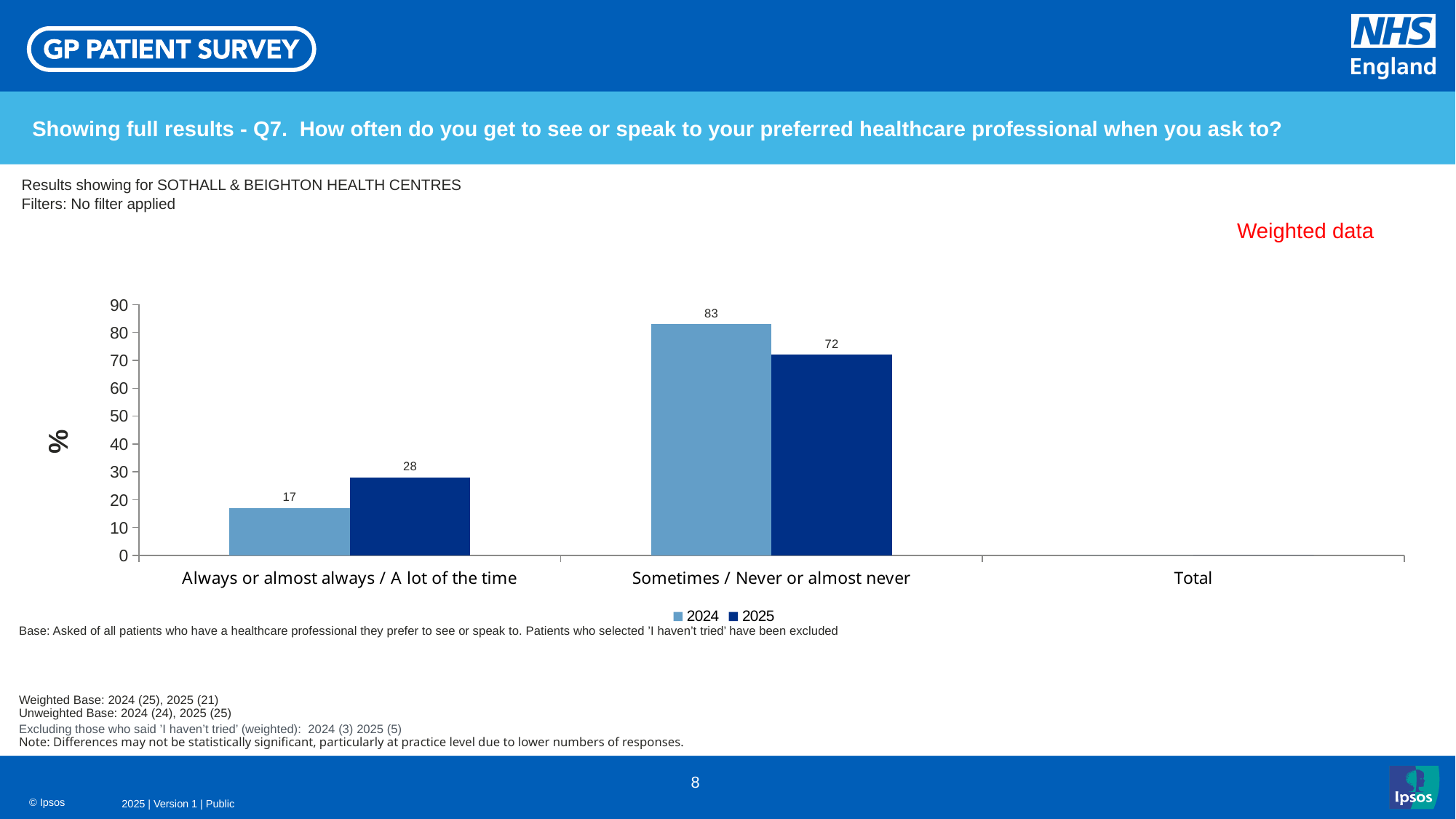
Which category has the highest 2024 value? Sometimes / Never or almost never What is the difference between the 2024 and 2025 values for 'Sometimes / Never or almost never'? 11 How many series does the legend list? 2 What is the 2025 value for 'Always or almost always / A lot of the time'? 28 What is the 2024 value for 'Always or almost always / A lot of the time'? 17 Is the 2024 value for 'Sometimes / Never or almost never' greater or less than 80? greater What is the 2024 value for 'Sometimes / Never or almost never'? 83 What is the difference between the 2025 and 2024 values for 'Always or almost always / A lot of the time'? 11 What kind of chart is shown on the slide? Bar chart What is the 2025 value for 'Sometimes / Never or almost never'? 72 What label is shown on the vertical axis of the chart? % Which is larger for 'Always or almost always / A lot of the time': the 2024 value or the 2025 value? 2025